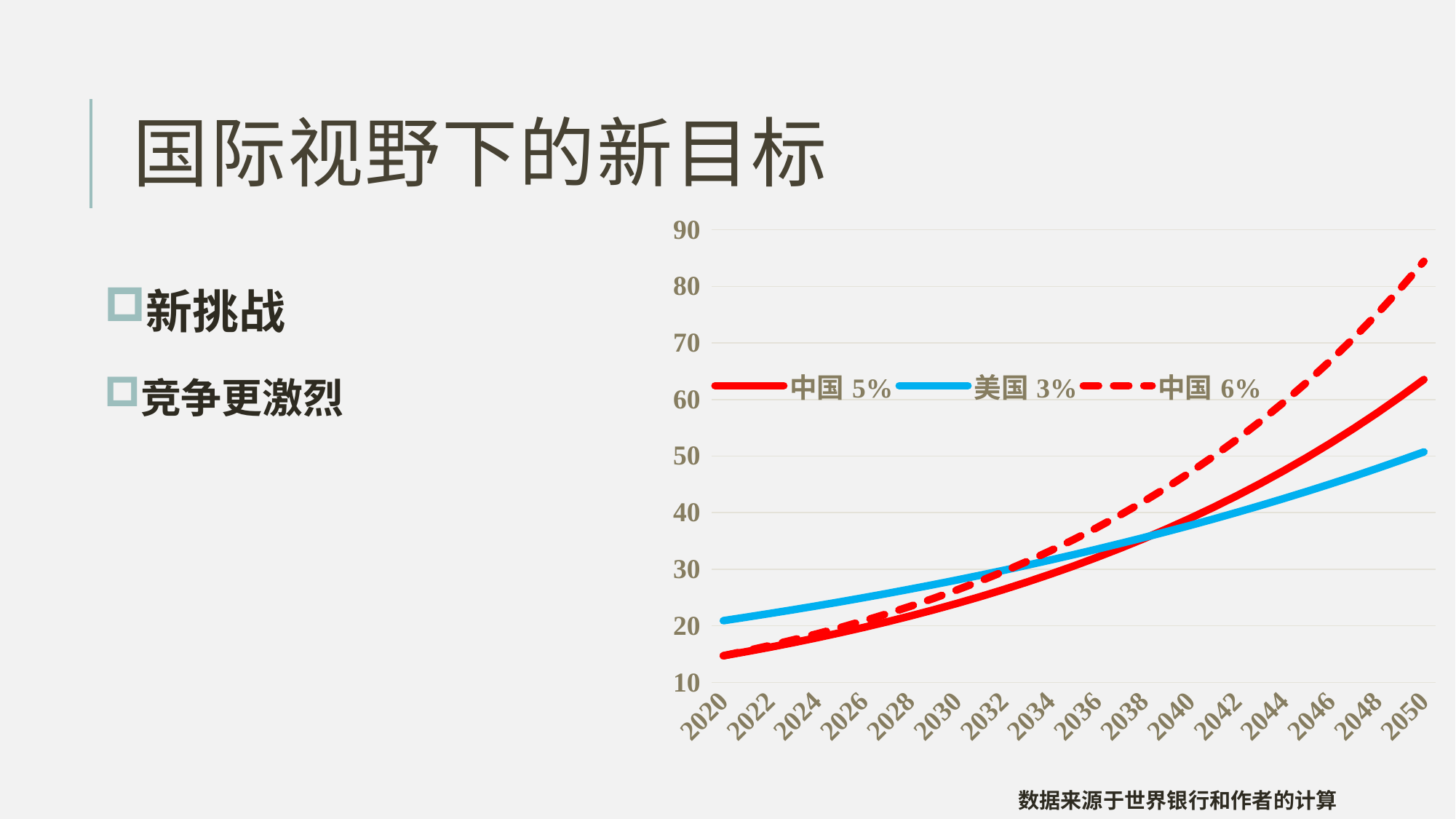
Is the value for 美国 3% in 2030 greater or less than 30? less Which series has the lowest value in 2050? 美国 3% Does the 中国 5% line rise or fall from 2020 to 2050? rise What are the three series listed in the chart's legend? 中国 5%, 美国 3%, 中国 6% Which series has the highest value in 2050? 中国 6% What kind of chart is shown on the slide? line chart How many year labels are shown on the x axis of the chart? 16 Which series has the highest value in 2020? 美国 3% Is the value for 中国 5% in 2020 greater or less than 20? less Is the value for 中国 6% in 2050 greater or less than 80? greater In 2050, which is larger: the value for 中国 5% or the value for 美国 3%? 中国 5% How many series does the chart's legend list? 3